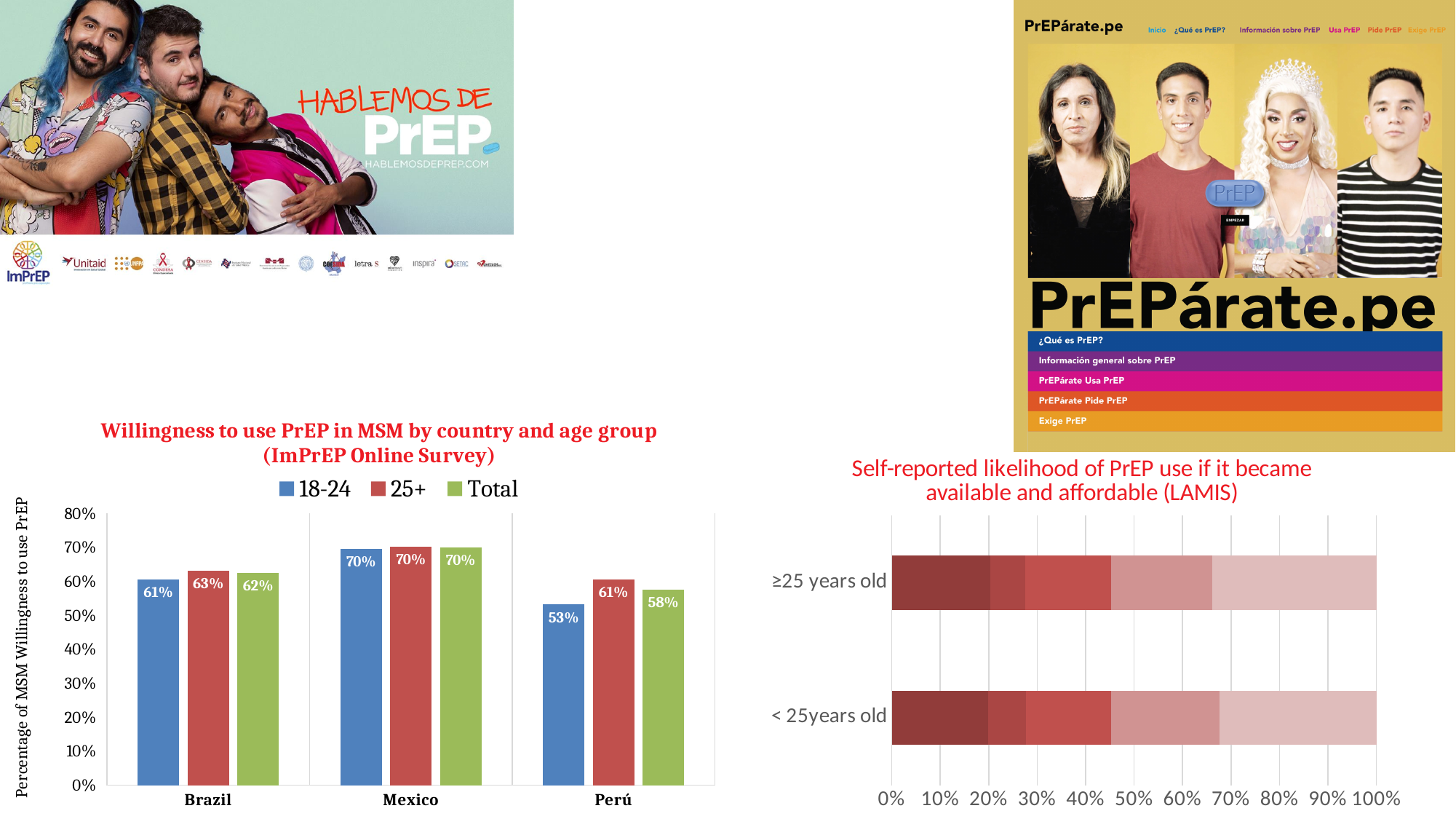
In the 'Willingness to use PrEP in MSM by country and age group' chart, which country has the highest Total value? Mexico In the 'Willingness to use PrEP in MSM by country and age group' chart, which is larger: the Total for Brazil or the Total for Perú? Brazil How many series does the legend of the 'Willingness to use PrEP in MSM by country and age group' chart list? 3 How many age-group categories are shown in the 'Self-reported likelihood of PrEP use if it became available and affordable (LAMIS)' chart? 2 In the 'Willingness to use PrEP in MSM by country and age group' chart, which country has the lowest value for the 18-24 group? Perú In the 'Willingness to use PrEP in MSM by country and age group' chart, what is the value for the 18-24 group in Brazil? 61% What kind of chart is the 'Willingness to use PrEP in MSM by country and age group' chart? Bar chart What kind of chart is the 'Self-reported likelihood of PrEP use if it became available and affordable (LAMIS)' chart? Stacked bar chart In the 'Willingness to use PrEP in MSM by country and age group' chart, what is the difference between the 25+ and 18-24 values for Perú? 8% In the 'Willingness to use PrEP in MSM by country and age group' chart, what is the value for the 25+ group in Perú? 61% How many countries are shown on the x axis of the 'Willingness to use PrEP in MSM by country and age group' chart? 3 In the 'Willingness to use PrEP in MSM by country and age group' chart, what is the Total value for Mexico? 70%